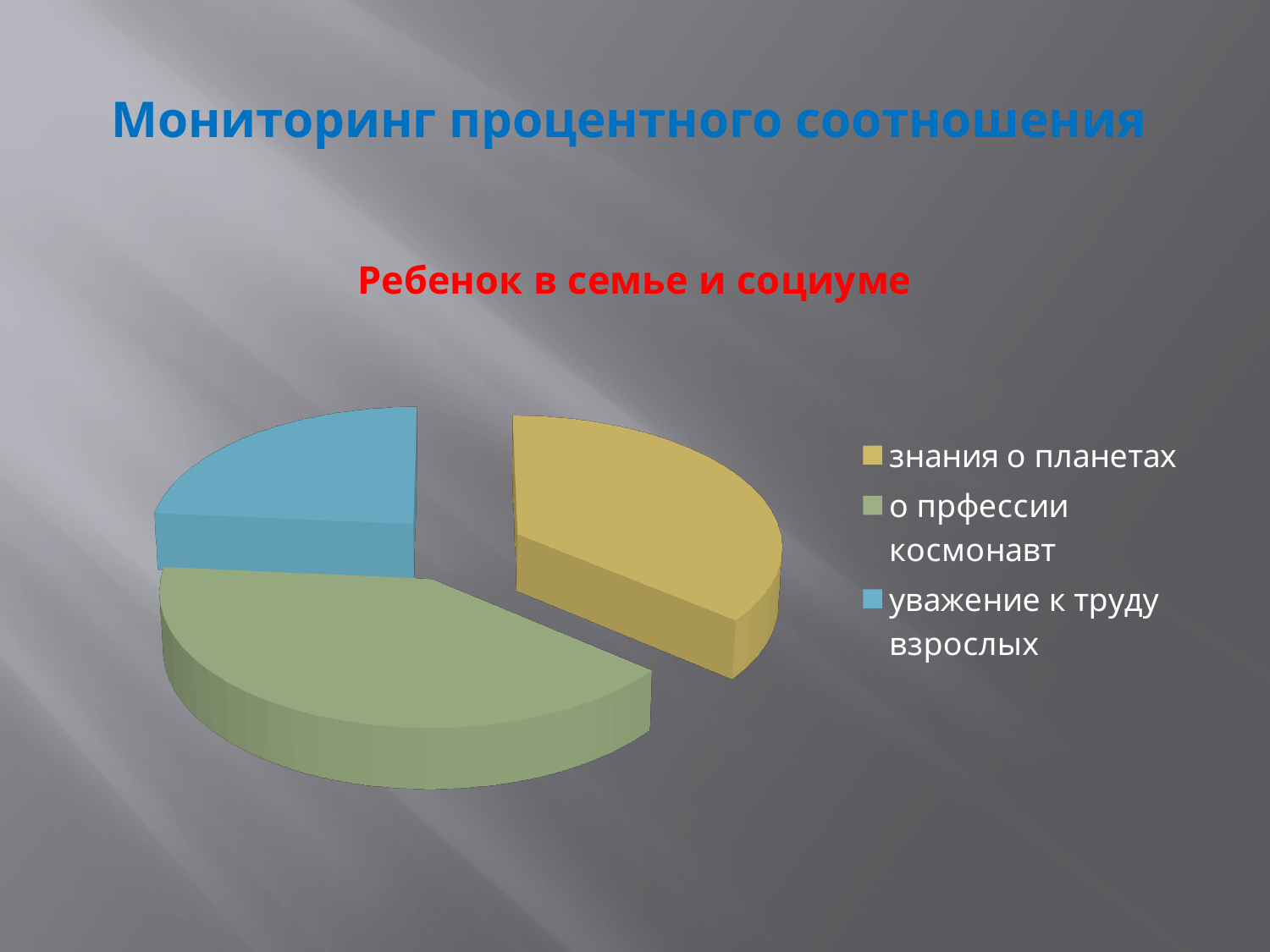
Which colour represents "уважение к труду взрослых" in the pie chart? blue What is the title shown above the pie chart in red? Ребенок в семье и социуме Which slice is larger: "знания о планетах" or "уважение к труду взрослых"? знания о планетах How many entries does the legend of the pie chart list? 3 Which category has the smallest slice of the pie chart? уважение к труду взрослых What kind of chart is shown on the slide? pie chart Which slice is larger: "о прфессии космонавт" or "знания о планетах"? о прфессии космонавт Which category has the largest slice of the pie chart? о прфессии космонавт How many slices does the pie chart have? 3